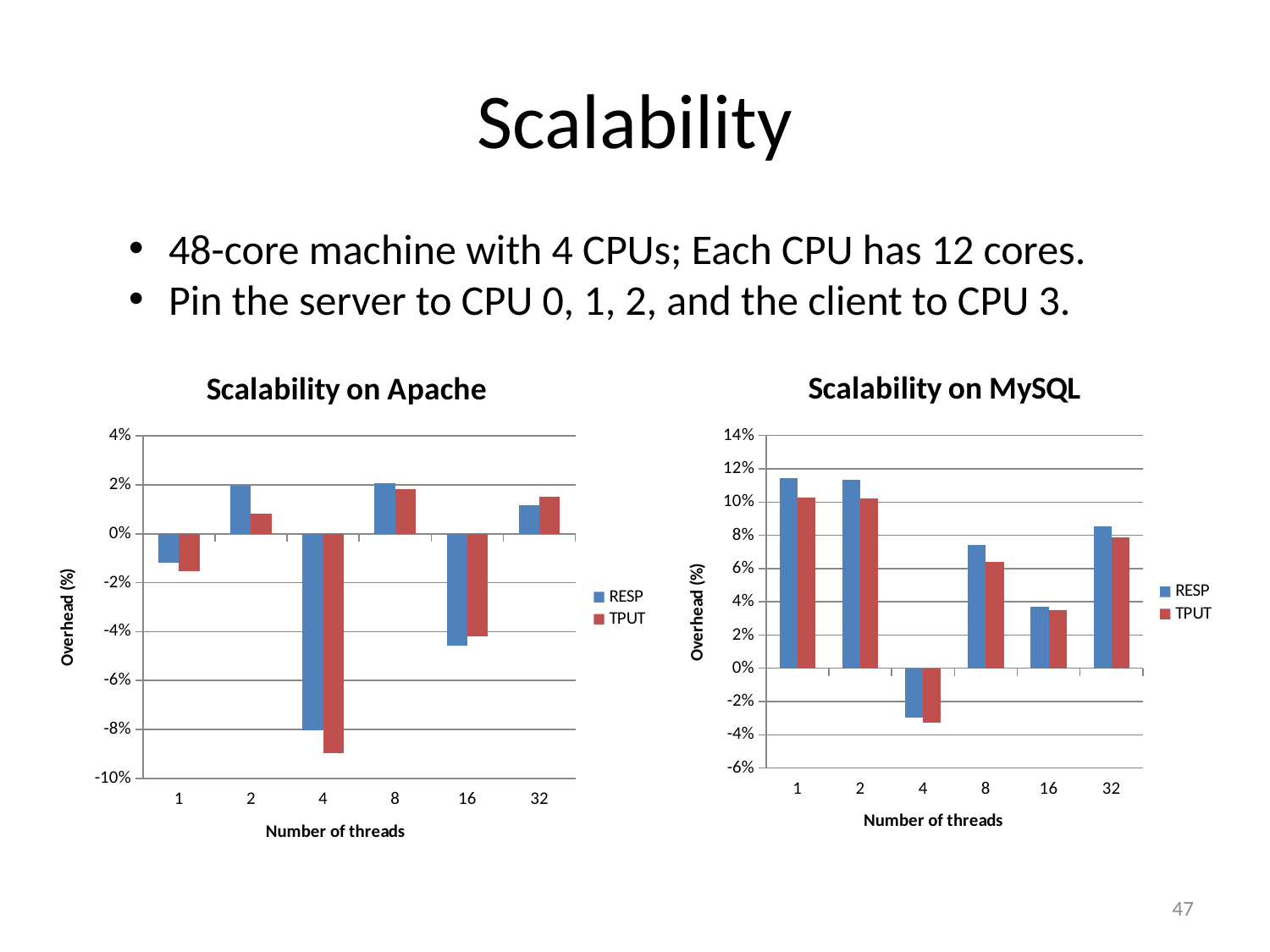
How many series does the legend of the 'Scalability on MySQL' chart list? 2 In the 'Scalability on Apache' chart, is the TPUT value for 4 threads greater or less than -8%? less How many thread-count categories are shown on the x axis of the 'Scalability on Apache' chart? 6 What type of chart is 'Scalability on Apache'? bar chart In the 'Scalability on MySQL' chart, is the RESP value for 32 threads greater or less than 8%? greater In the 'Scalability on MySQL' chart, is the TPUT value for 16 threads greater or less than 4%? less In the 'Scalability on MySQL' chart, at which number of threads is the TPUT overhead lowest? 4 In the 'Scalability on Apache' chart, at 4 threads, which series extends further below 0%, RESP or TPUT? TPUT In the 'Scalability on Apache' chart, at which number of threads is the RESP overhead lowest? 4 In the 'Scalability on MySQL' chart, at 8 threads, which series has the higher overhead, RESP or TPUT? RESP